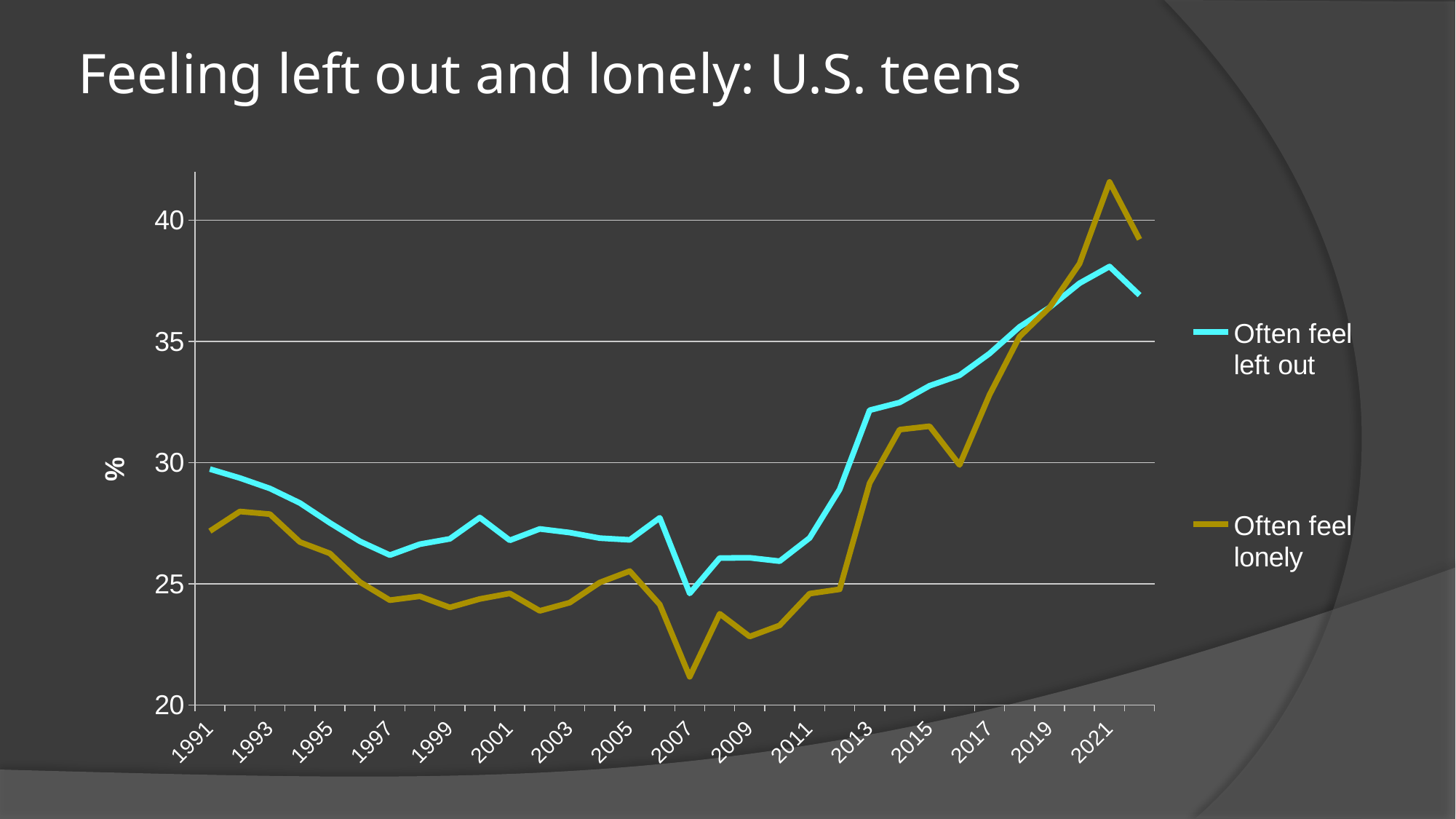
Is the value for Often feel left out in 2021 greater or less than 35? greater How many series does the legend list? 2 In which year does the Often feel lonely series reach its lowest value? 2007 In 2021, which series has the higher value, Often feel left out or Often feel lonely? Often feel lonely What is the title of the chart? Feeling left out and lonely: U.S. teens What is the label on the vertical axis? % Is the value for Often feel left out in 2013 greater or less than 30? greater Is the value for Often feel lonely in 2021 greater or less than 40? greater In 2007, which series has the higher value, Often feel left out or Often feel lonely? Often feel left out Between 2013 and 2021, does the Often feel left out series rise or fall? rise What kind of chart is shown on the slide? line chart